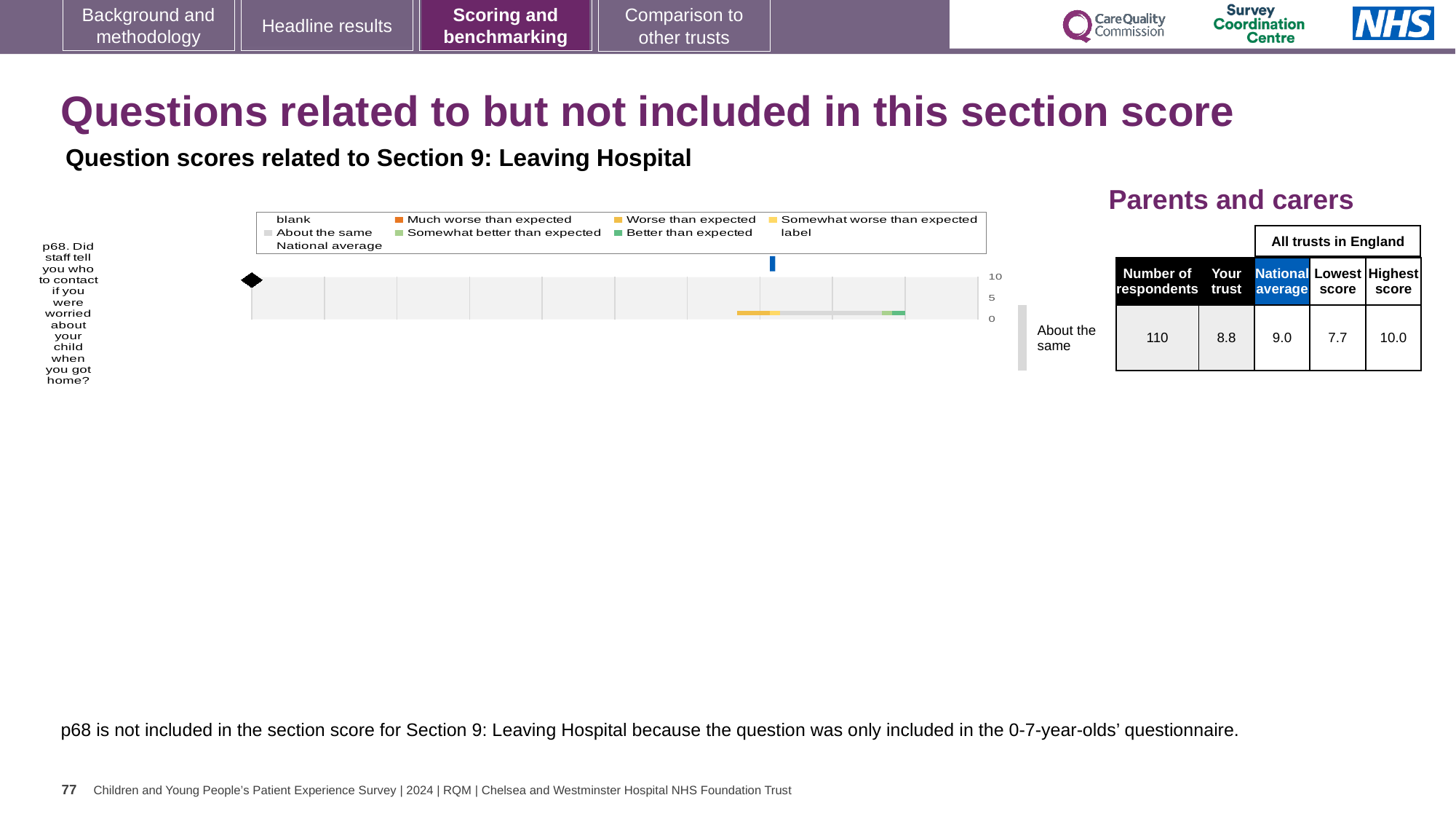
What is the highest value shown on the chart's axis? 10 What is the highest score among all trusts in England for p68? 10.0 How many questions (categories) are plotted in the chart? 1 What is the lowest score among all trusts in England for p68? 7.7 Which is larger for p68, the 'Your trust' score or the national average? national average What benchmark category label is shown next to the chart for p68? About the same What is the 'Your trust' score for p68? 8.8 What kind of chart is shown for question p68? bar chart How many respondents answered p68? 110 How many entries does the chart legend list? 9 What is the national average score for p68? 9.0 Which legend entry is shown in orange? Much worse than expected